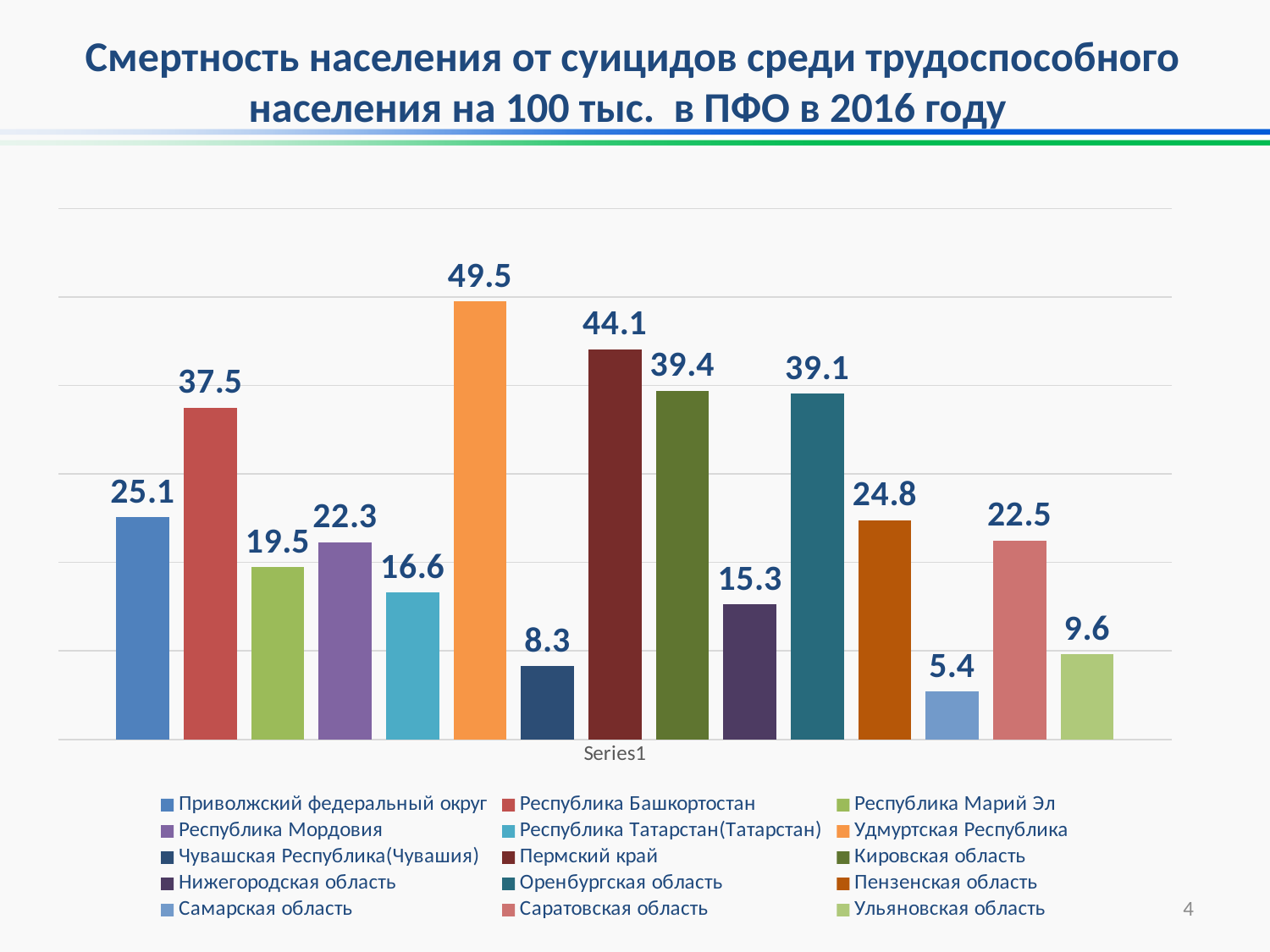
What is the difference between the values for Республика Башкортостан and Приволжский федеральный округ? 12.4 What kind of chart is shown on the slide? Bar chart Which is larger, the value for Кировская область or the value for Пензенская область? Кировская область Which region has the lowest value? Самарская область How many entries does the legend list? 15 What is the value for Самарская область? 5.4 What is the value for Пермский край? 44.1 What is the value for Приволжский федеральный округ? 25.1 Which region has the highest value? Удмуртская Республика What is the difference between the values for Удмуртская Республика and Пермский край? 5.4 How many bars are plotted on the chart? 15 What is the value for Удмуртская Республика? 49.5